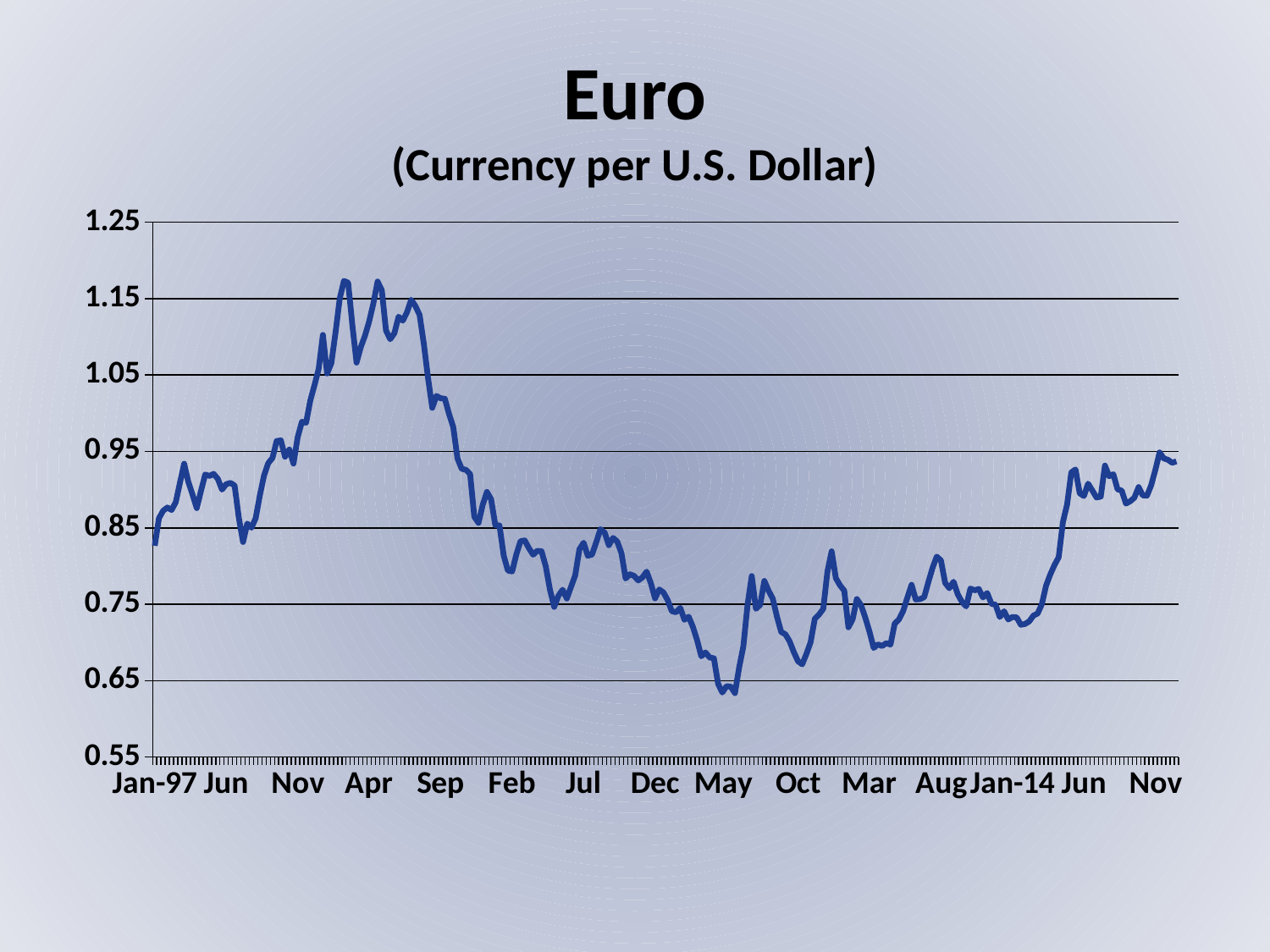
Does the line generally rise or fall between Jan-14 and Nov? rise Is the value at Jan-14 greater or less than 0.85? less Does the line generally rise or fall between Jan-97 and Apr? rise Is the value at the final Nov greater or less than 0.85? greater How many labels are shown along the x axis? 15 Is the value around May (the lowest point of the line) greater or less than 0.75? less What is the title of the chart? Euro What unit does the chart's subtitle say the values are in? Currency per U.S. Dollar What kind of chart is shown on the slide? line chart Does the line generally rise or fall between Apr and May? fall